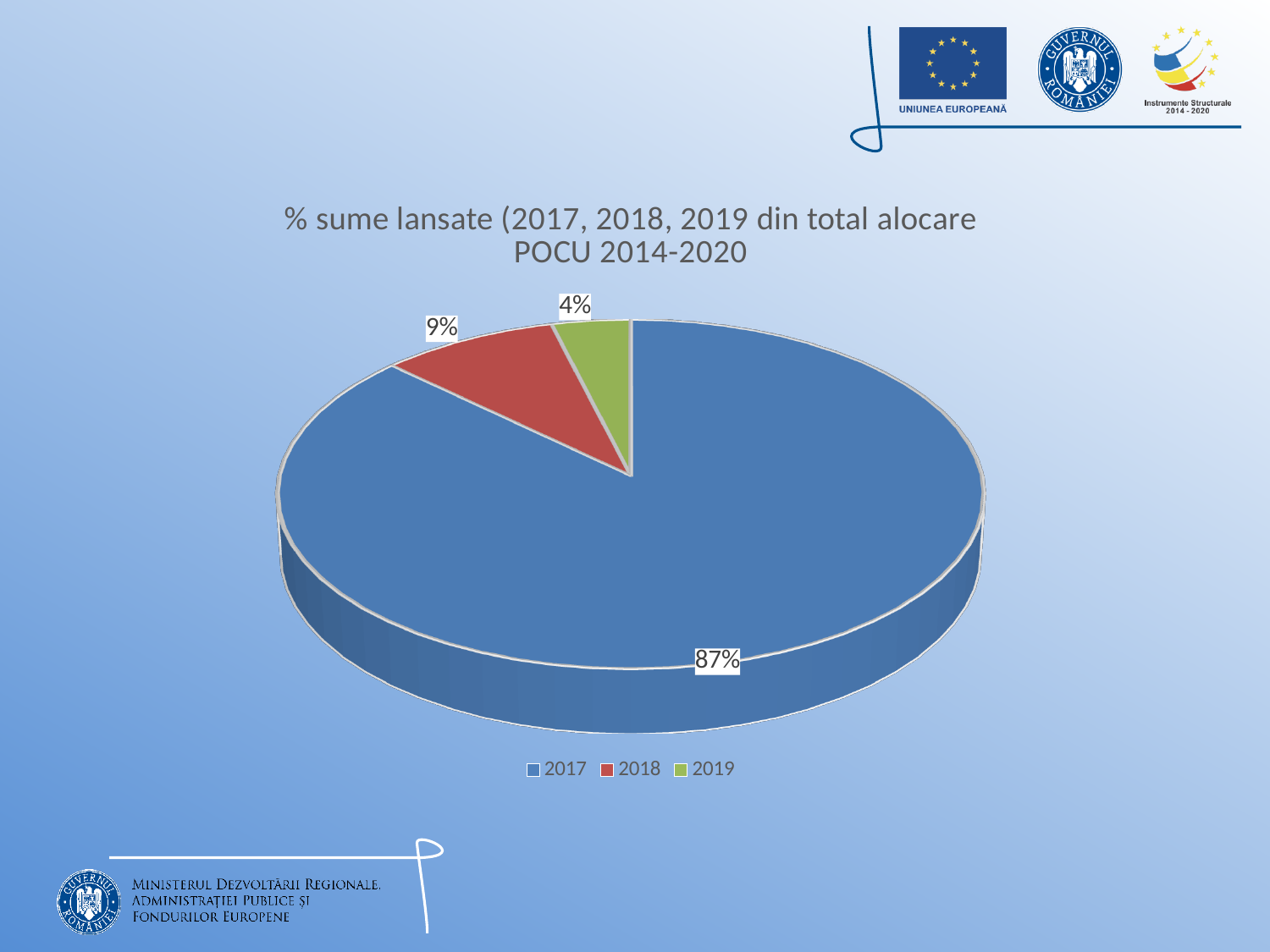
How many slices does the pie chart have? 3 Which is larger, the share for 2018 or the share for 2019? 2018 What is the difference between the shares for 2017 and 2018? 78% How many entries does the legend list? 3 What colour is the slice for 2018? Red What share of the pie does 2019 have? 4% Which year has the smallest slice of the pie? 2019 What share of the pie does 2018 have? 9% What kind of chart is shown on the slide? Pie chart Which year has the largest slice of the pie? 2017 What is the difference between the shares for 2018 and 2019? 5% What share of the pie does 2017 have? 87%